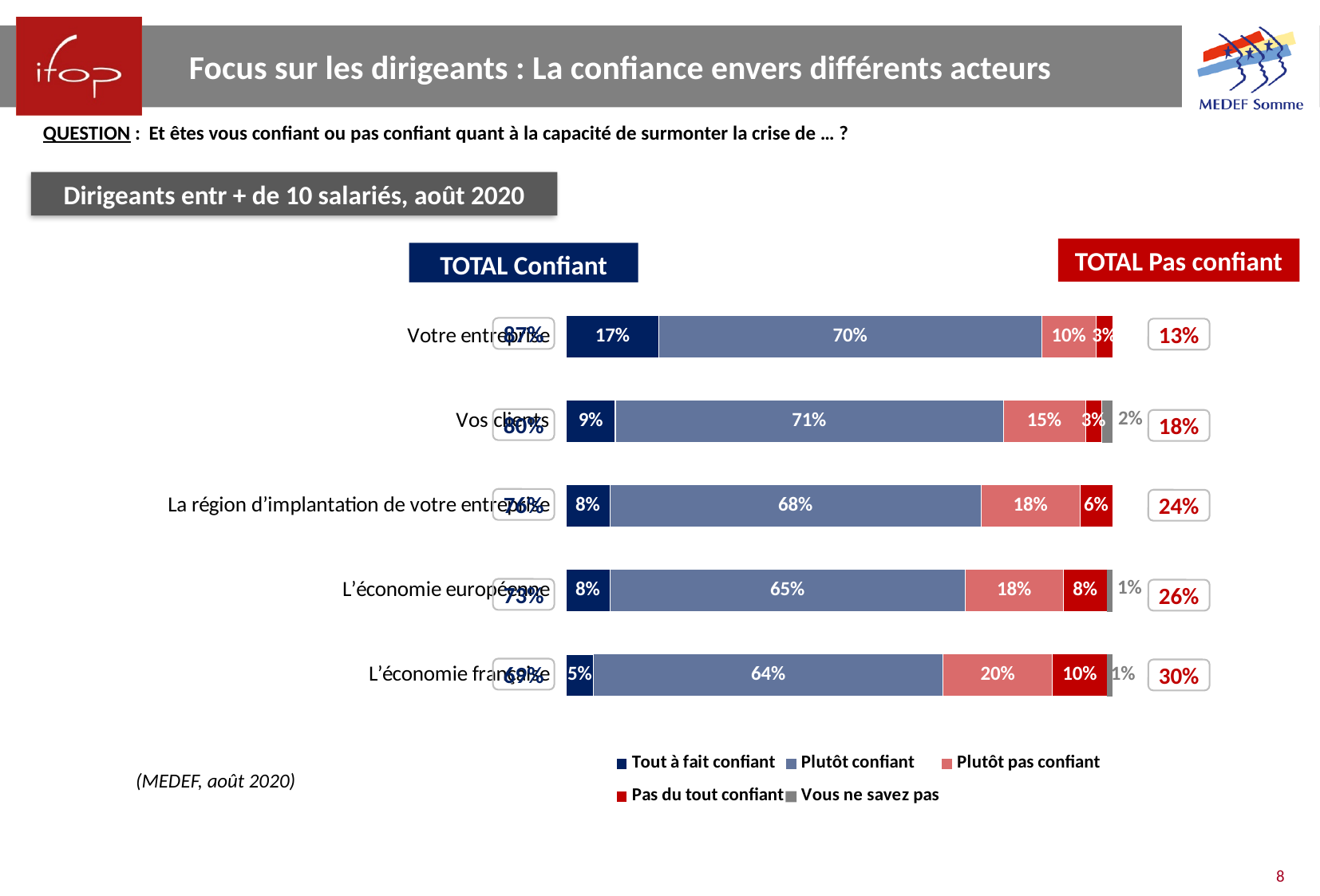
What colour represents "Pas du tout confiant" in the legend? Red What percentage of respondents are "Plutôt confiant" about Vos clients? 71% What is the TOTAL Pas confiant value for L'économie française? 30% Which has a larger "Plutôt confiant" value: Votre entreprise or L'économie européenne? Votre entreprise How many series does the legend list? 5 What kind of chart is shown on the slide? Stacked bar chart What is the difference in "Plutôt pas confiant" between L'économie française and Votre entreprise? 10 points How many categories are shown in the chart? 5 Which category has the lowest "Tout à fait confiant" value? L'économie française What is the "Tout à fait confiant" value for Votre entreprise? 17% What is the "Vous ne savez pas" value for Vos clients? 2% Which category has the highest "Pas du tout confiant" value? L'économie française